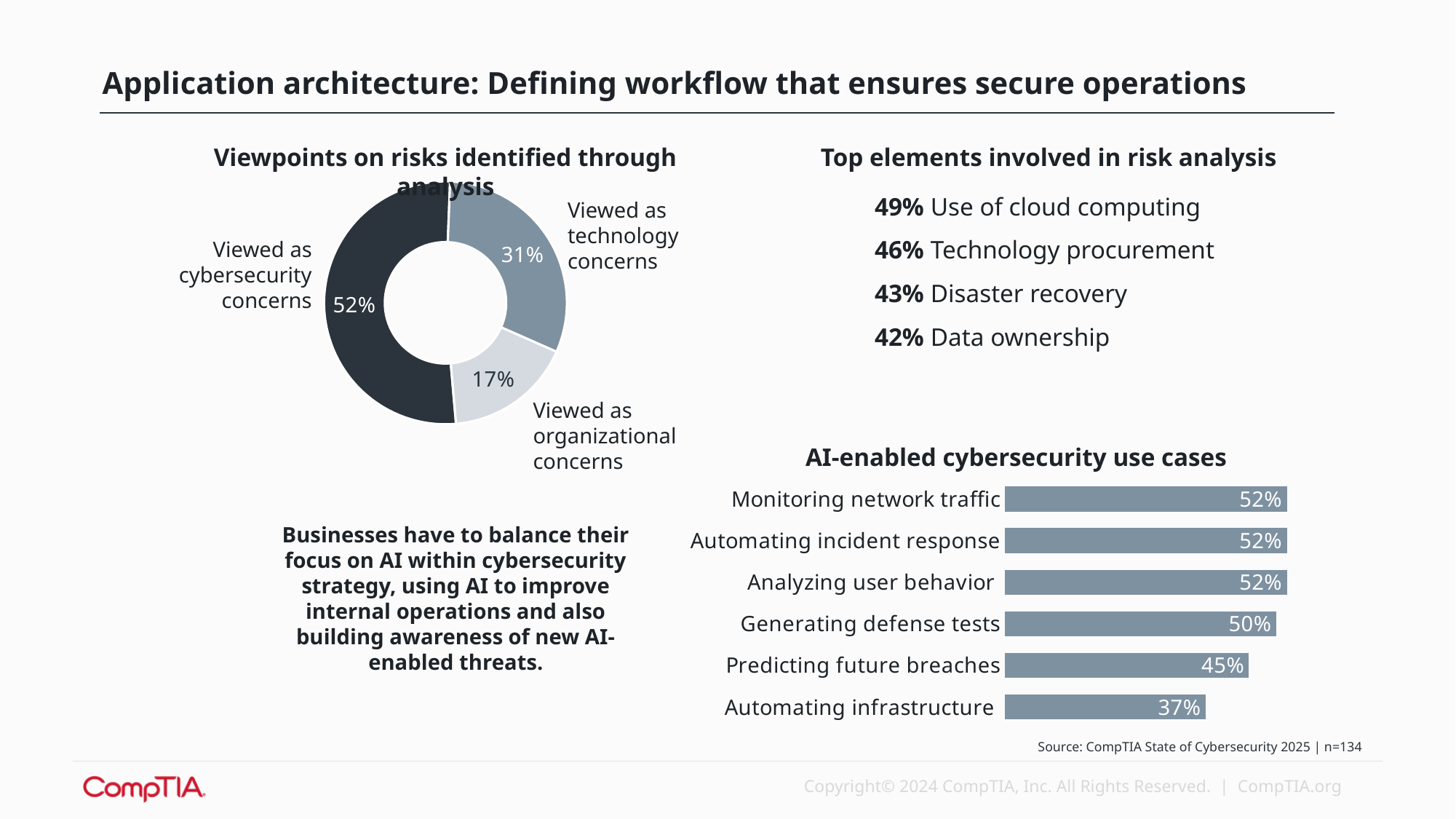
In the 'AI-enabled cybersecurity use cases' chart, what is the value for Generating defense tests? 50% In the 'Viewpoints on risks identified through analysis' chart, what share is viewed as technology concerns? 31% In the 'Viewpoints on risks identified through analysis' chart, what is the difference between the cybersecurity concerns share and the organizational concerns share? 35% In the 'AI-enabled cybersecurity use cases' chart, which use case has the lowest value? Automating infrastructure In the 'Viewpoints on risks identified through analysis' chart, how many slices are there? 3 In the 'AI-enabled cybersecurity use cases' chart, what is the value for Predicting future breaches? 45% What kind of chart is 'Viewpoints on risks identified through analysis'? Donut chart In the 'Viewpoints on risks identified through analysis' chart, what share is viewed as cybersecurity concerns? 52% In the 'AI-enabled cybersecurity use cases' chart, how many use cases are shown? 6 In the 'Viewpoints on risks identified through analysis' chart, which category has the smallest share? Viewed as organizational concerns What kind of chart is 'AI-enabled cybersecurity use cases'? Bar chart In the 'AI-enabled cybersecurity use cases' chart, what is the difference between Monitoring network traffic and Automating infrastructure? 15%